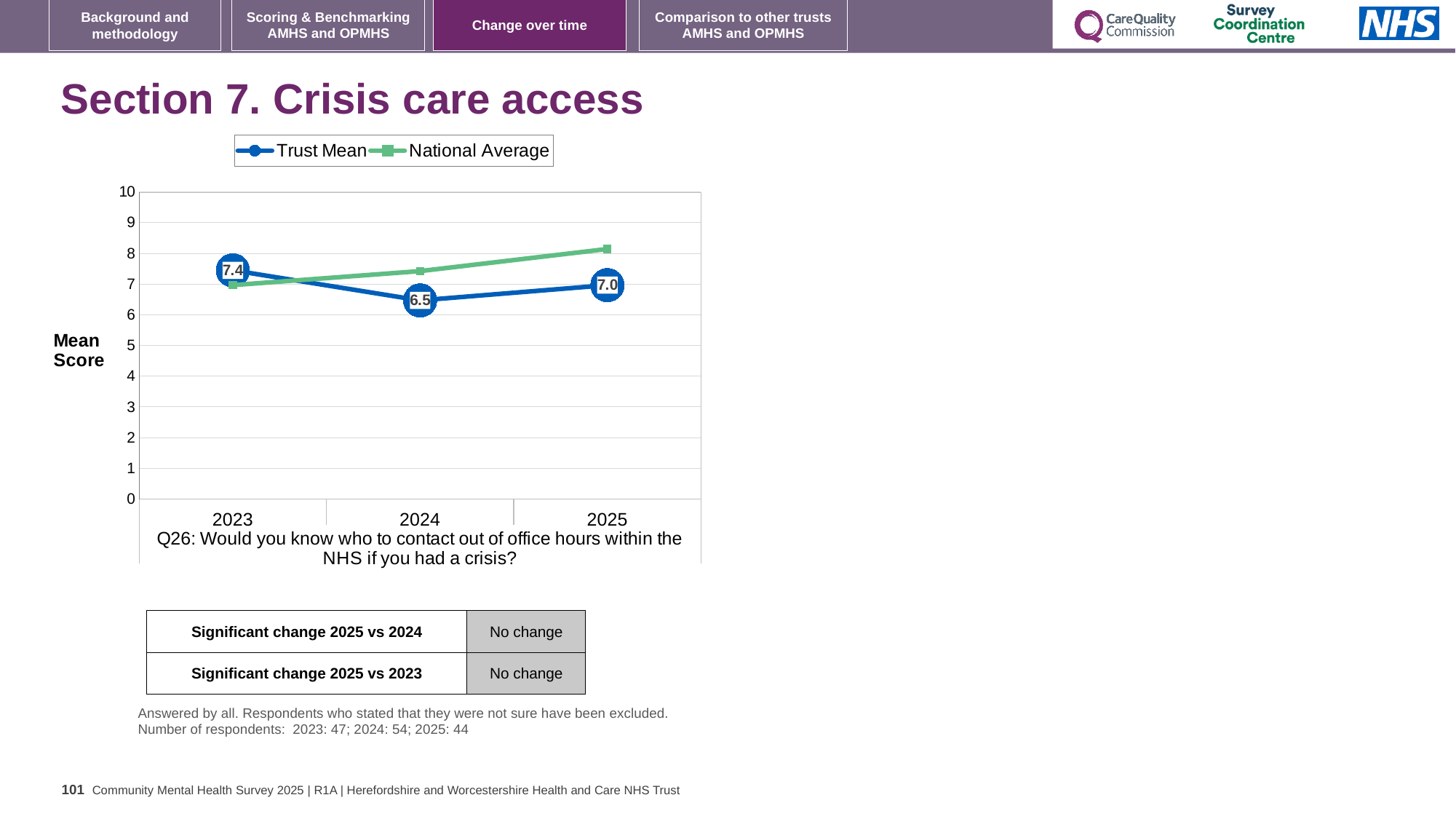
What is the difference between the Trust Mean scores for 2023 and 2024? 0.9 What is the Trust Mean score for 2023? 7.4 In which year is the Trust Mean score highest? 2023 Does the National Average line rise or fall from 2023 to 2025? Rise Is the National Average value for 2025 greater or less than 7? greater Which year has the larger Trust Mean score, 2023 or 2025? 2023 In which year is the Trust Mean score lowest? 2024 How many series does the legend list? 2 What kind of chart is shown on the slide? Line chart What is the Trust Mean score for 2025? 7.0 What is the Trust Mean score for 2024? 6.5 How many years are plotted on the x axis? 3